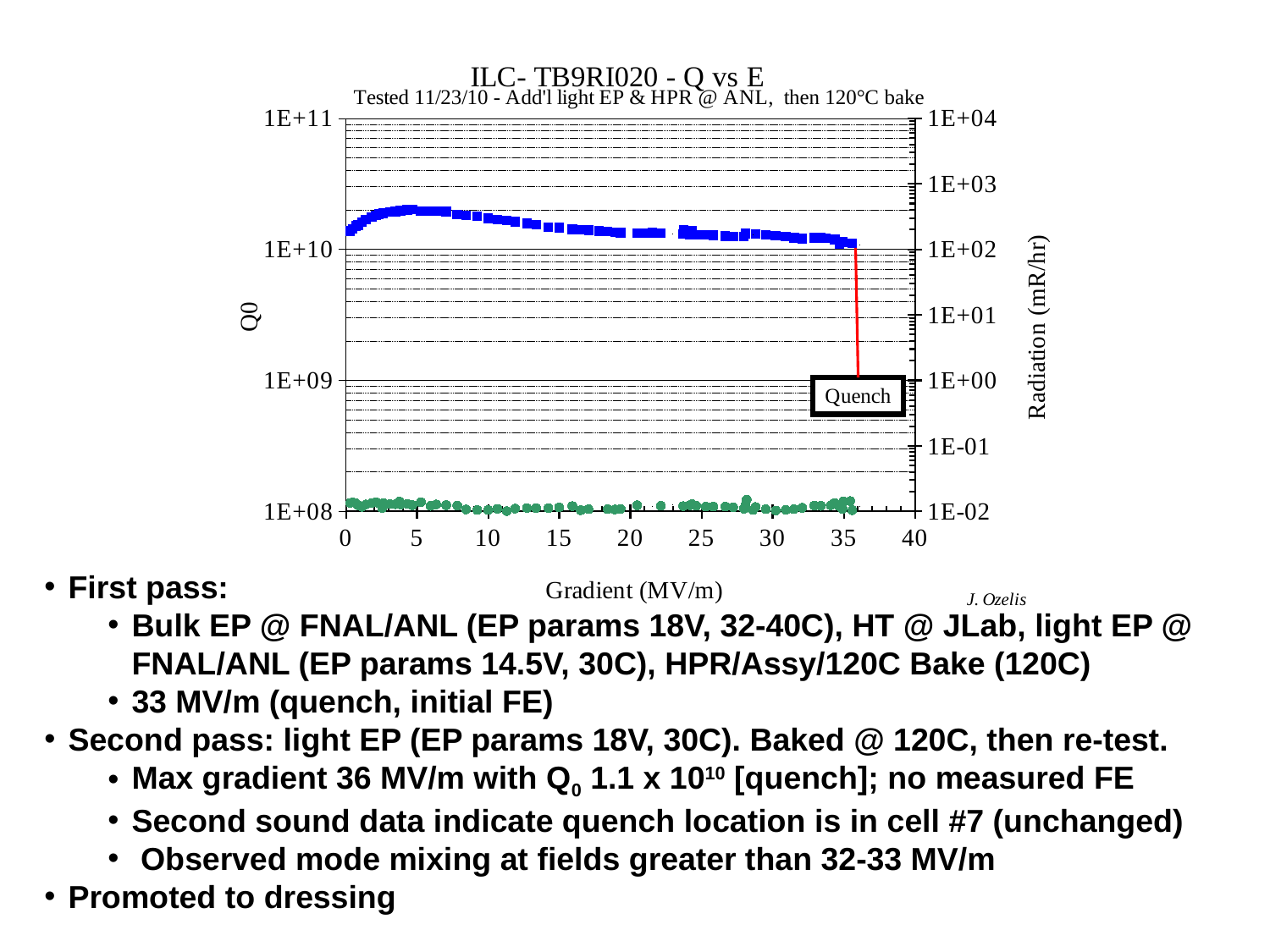
What is the title of the chart? ILC- TB9RI020 - Q vs E What is the label of the x axis of the chart? Gradient (MV/m) Does the Q0 series rise or fall as the gradient increases from 10 MV/m to 35 MV/m? fall Is the radiation value at a gradient of 10 MV/m greater or less than 1E-01 mR/hr? less Is the Q0 value at a gradient of 20 MV/m greater or less than 1E+11? less Is the Q0 value at a gradient of 5 MV/m greater or less than 1E+10? greater What kind of chart is shown on the slide? scatter chart What is the highest tick value shown on the x axis of the chart? 40 Which series has the higher value at a gradient of 15 MV/m, the blue Q0 series or the green radiation series (each read on its own axis)? the blue Q0 series